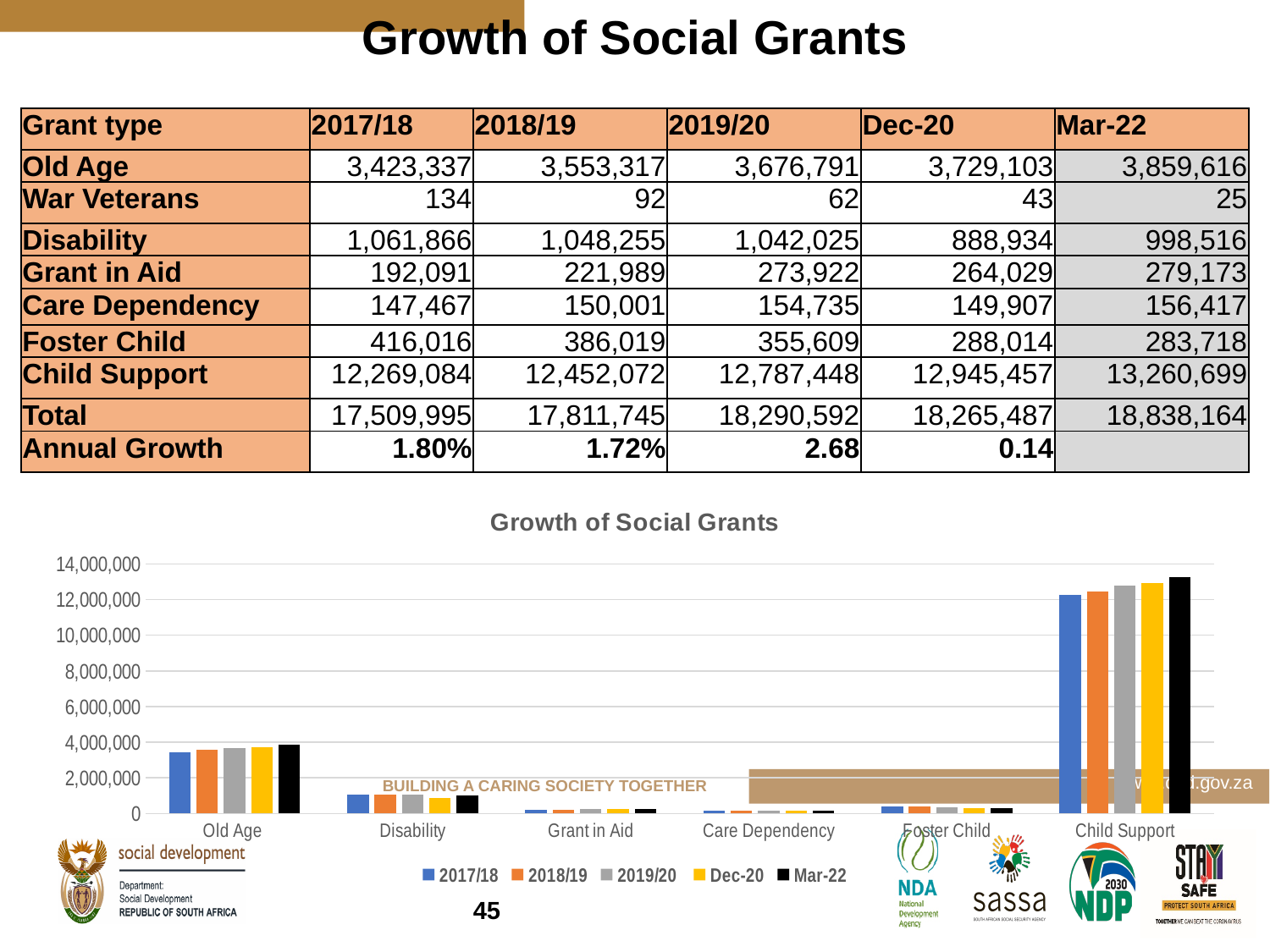
Do the Foster Child bars rise or fall from 2017/18 to Mar-22? fall Which is larger in the chart: the Mar-22 bar for Old Age or the Mar-22 bar for Foster Child? Old Age How many grant type categories are plotted on the x axis of the chart? 6 What colour are the Mar-22 bars in the chart? black Is the Mar-22 value for Disability greater or less than 2,000,000? less Is the Mar-22 value for Child Support greater or less than 12,000,000? greater Is the 2017/18 value for Old Age greater or less than 4,000,000? less What kind of chart is shown on the slide? bar chart Do the Child Support bars rise or fall from 2017/18 to Mar-22? rise Which grant type has the tallest bars in the chart? Child Support How many series does the chart legend list? 5 What is the title of the chart? Growth of Social Grants